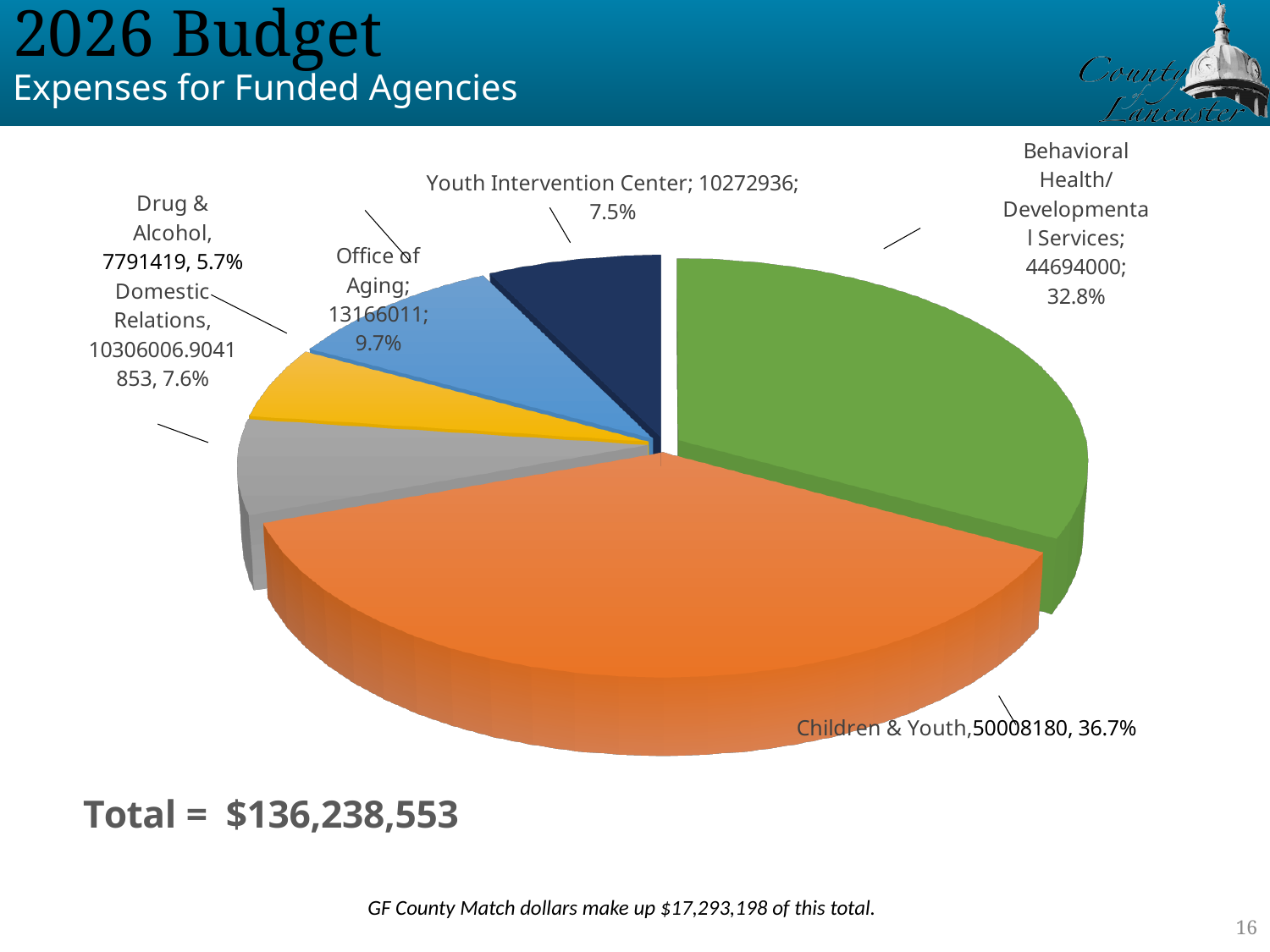
How many slices does the pie chart have? 6 Which category has the smallest slice of the pie? Drug & Alcohol What percentage share does Behavioral Health/Developmental Services have? 32.8% Which category has the largest slice of the pie? Children & Youth What kind of chart is shown on the slide? pie chart What is the value shown for Children & Youth? 50008180 What is the difference between the values for Children & Youth and Behavioral Health/Developmental Services? 5314180 Which is larger, the value for Office of Aging or the value for Youth Intervention Center? Office of Aging What percentage share does Youth Intervention Center have? 7.5% What total is stated below the pie chart? $136,238,553 What is the value shown for Office of Aging? 13166011 What percentage share does Domestic Relations have? 7.6%